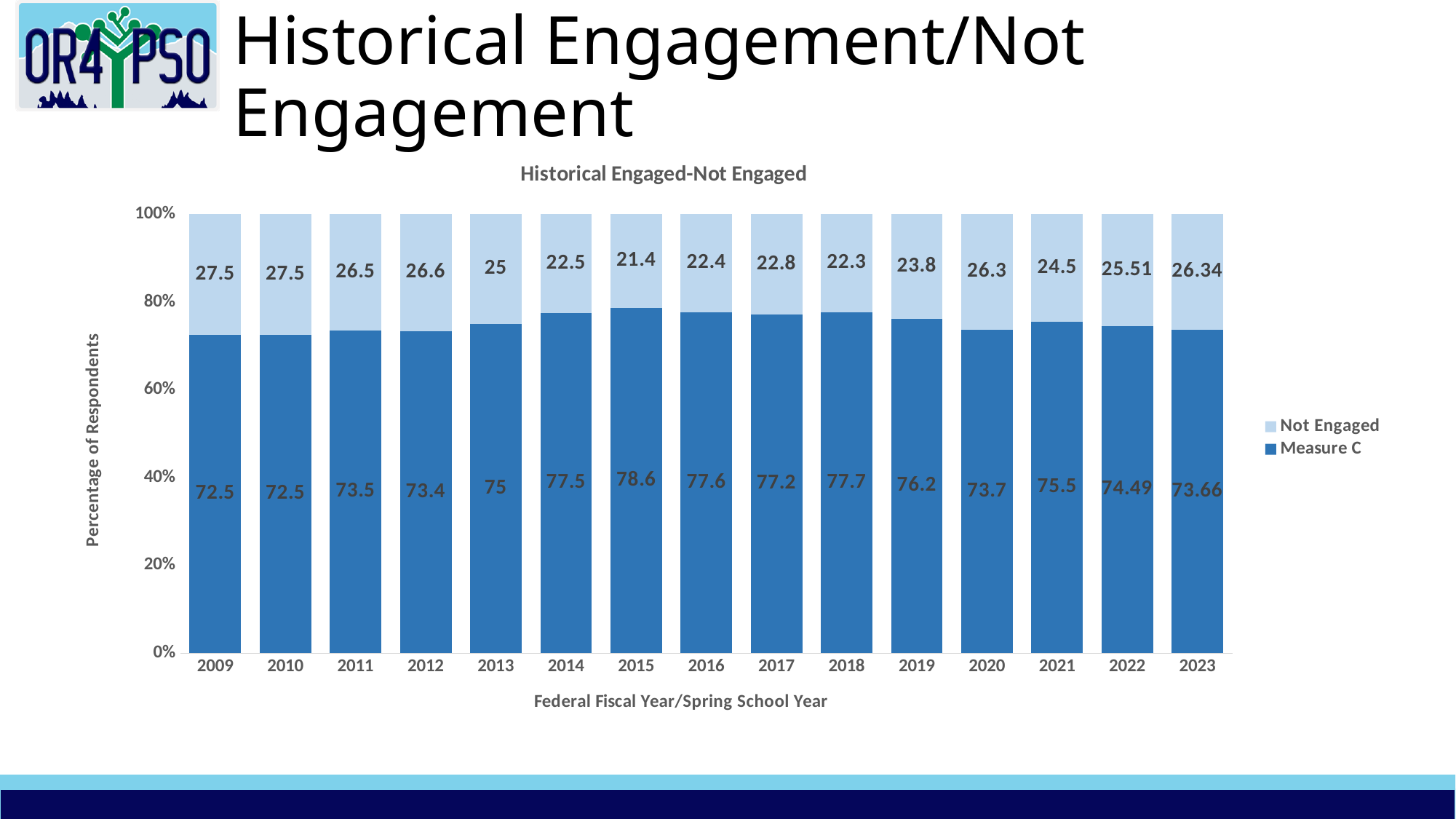
How many series does the legend list? 2 Which year has the lowest Not Engaged value? 2015 Which is larger, the Not Engaged value for 2020 or for 2021? 2020 What is the Measure C value for 2015? 78.6 What is the label of the x axis? Federal Fiscal Year/Spring School Year What kind of chart is shown? Stacked bar chart What is the title of the chart? Historical Engaged-Not Engaged How many years are shown on the x axis? 15 What is the Not Engaged value for 2023? 26.34 What is the Measure C value for 2022? 74.49 What is the difference between the Measure C values for 2015 and 2009? 6.1 Which year has the highest Measure C value? 2015